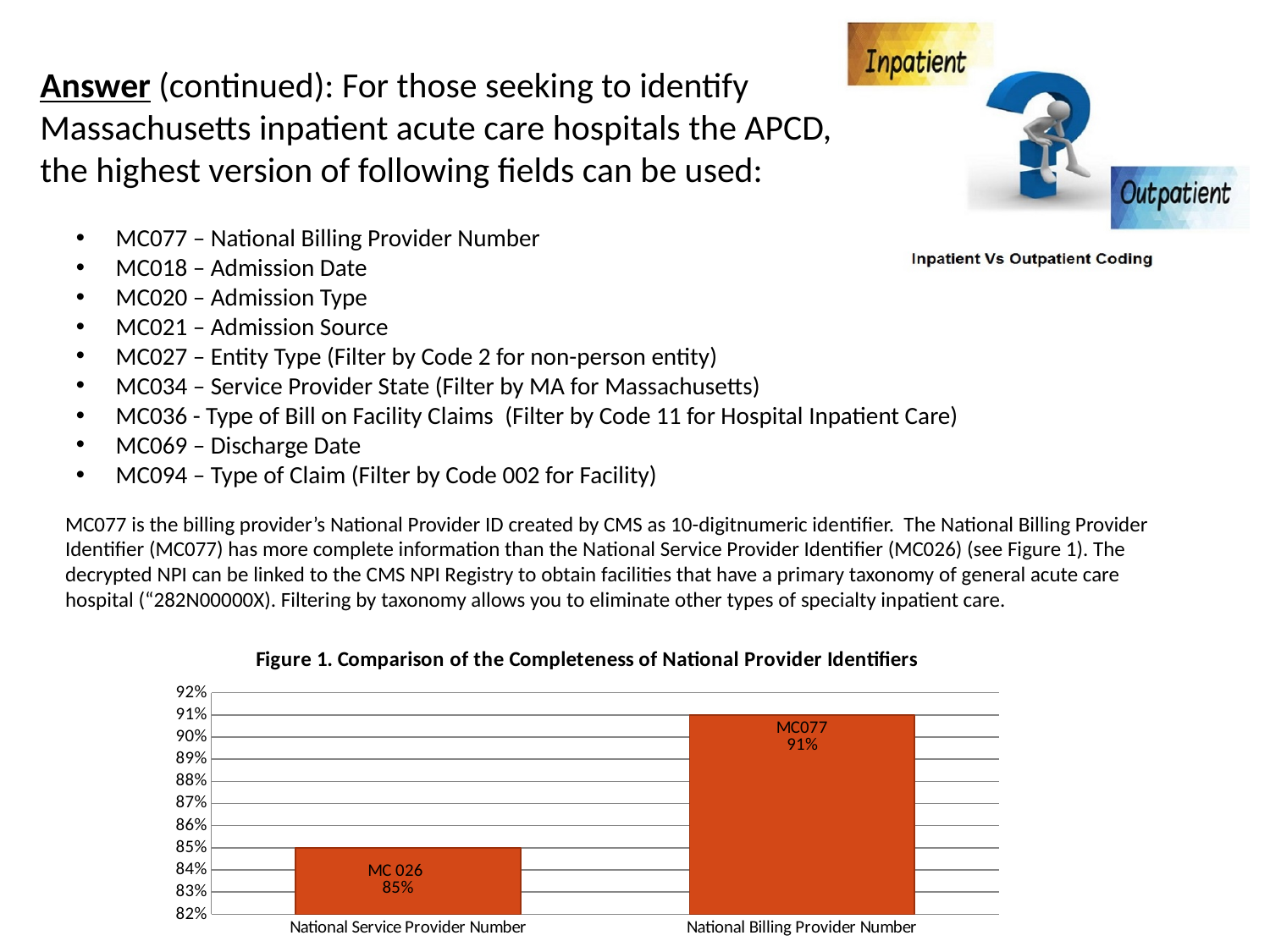
How many categories are shown in the chart? 2 Is the value for National Service Provider Number greater or less than 88%? less Which category has the highest value? National Billing Provider Number What is the value for National Billing Provider Number? 91% Is the value for National Billing Provider Number greater or less than 90%? greater What kind of chart is shown? bar chart Which is larger, the value for National Service Provider Number or National Billing Provider Number? National Billing Provider Number Which category has the lowest value? National Service Provider Number What is the value for National Service Provider Number? 85% What is the title of the chart? Figure 1. Comparison of the Completeness of National Provider Identifiers Which field code is labelled on the bar for National Service Provider Number? MC 026 What is the difference between the values for National Billing Provider Number and National Service Provider Number? 6%